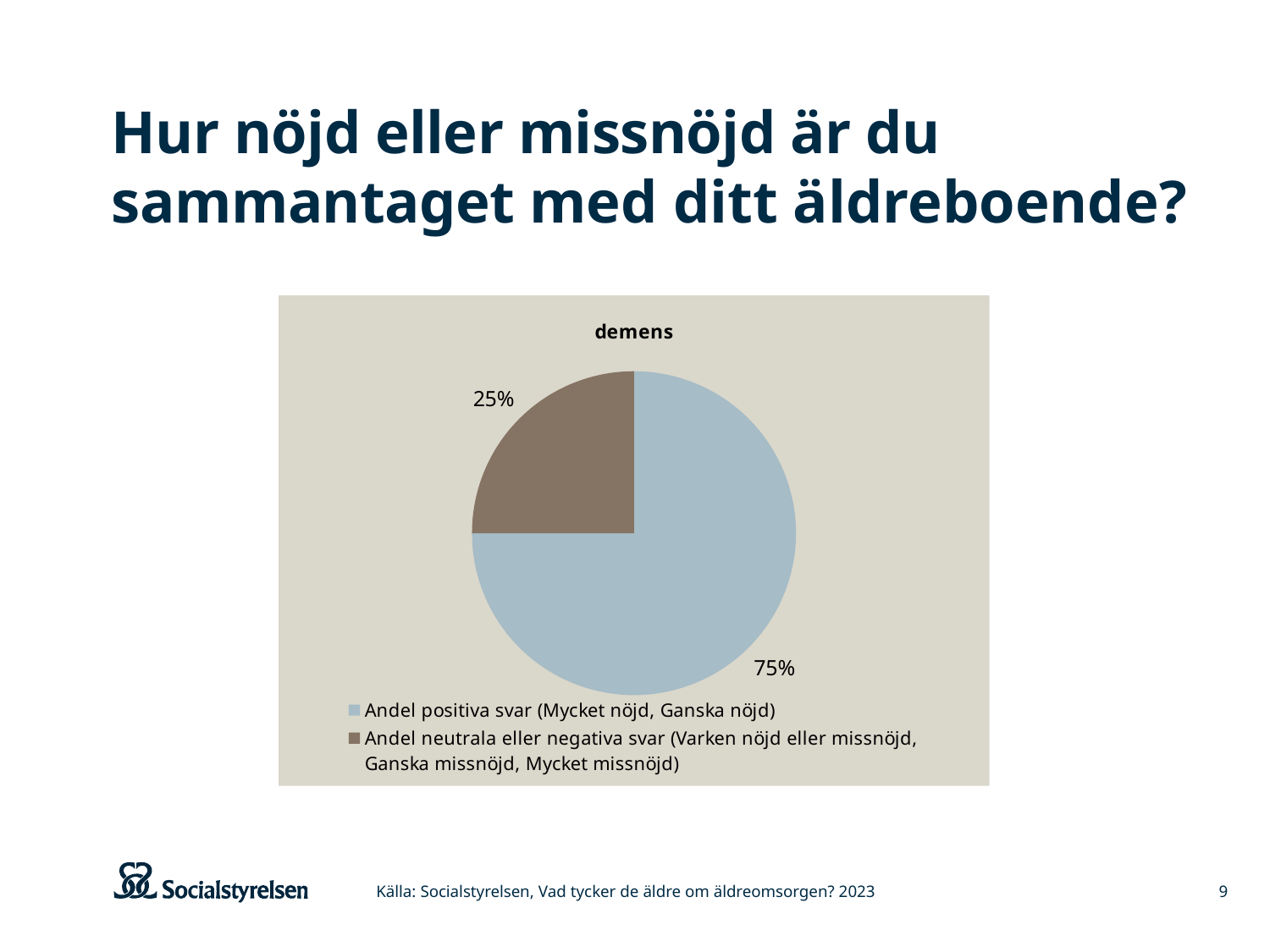
What kind of chart is shown on the slide? Pie chart What is the chart's title? demens What share of the pie is 'Andel neutrala eller negativa svar (Varken nöjd eller missnöjd, Ganska missnöjd, Mycket missnöjd)'? 25% How many entries does the legend list? 2 What colour is the slice for 'Andel positiva svar (Mycket nöjd, Ganska nöjd)'? Light blue-grey Which slice of the pie is the largest? Andel positiva svar (Mycket nöjd, Ganska nöjd) How many slices does the pie chart have? 2 What share of the pie is 'Andel positiva svar (Mycket nöjd, Ganska nöjd)'? 75% Which is larger: the share of positive answers or the share of neutral or negative answers? Andel positiva svar (Mycket nöjd, Ganska nöjd) What is the difference in percentage points between the positive-answer slice and the neutral-or-negative slice? 50 percentage points Which slice of the pie is the smallest? Andel neutrala eller negativa svar (Varken nöjd eller missnöjd, Ganska missnöjd, Mycket missnöjd)